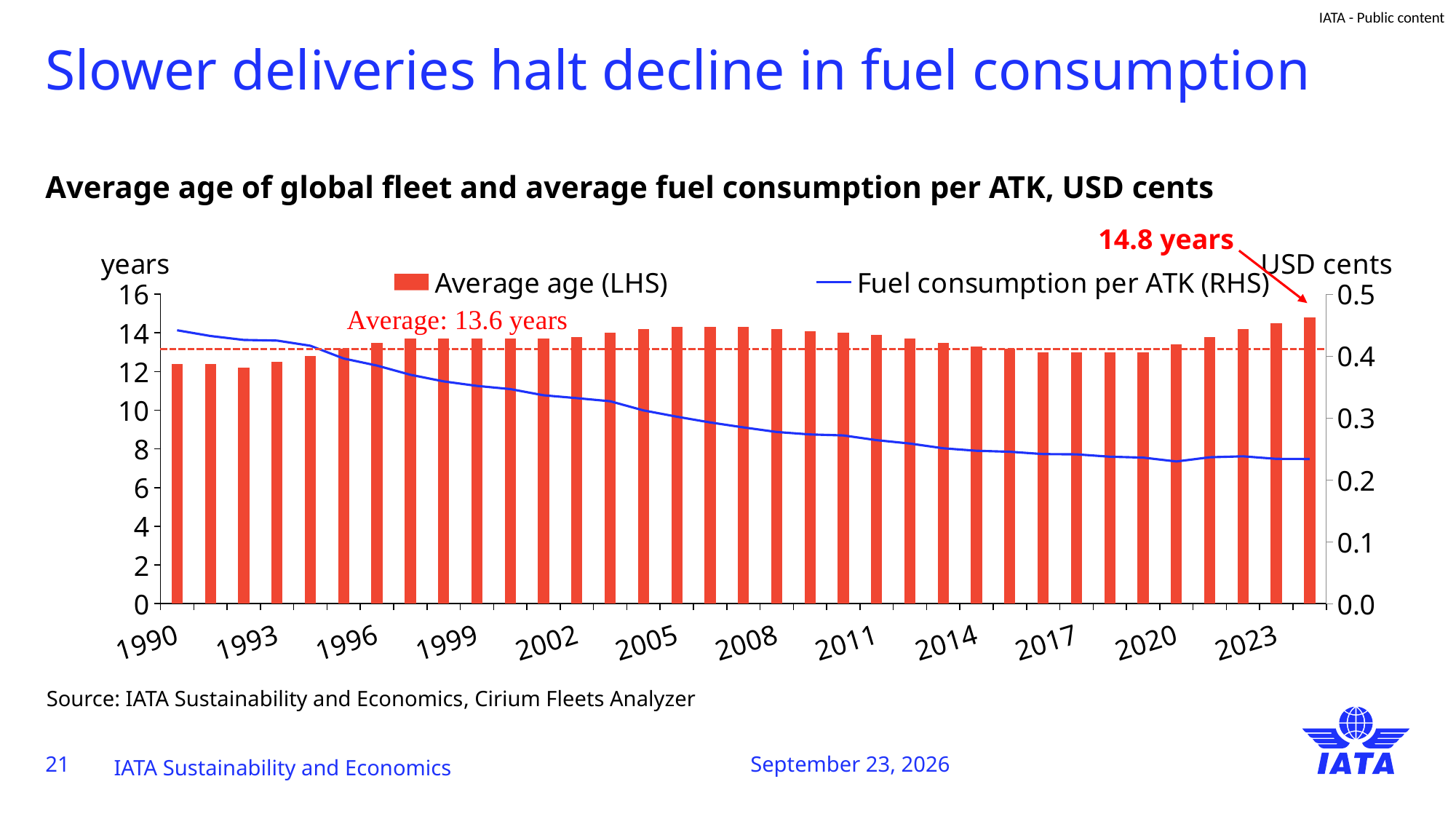
How many series does the legend list? 2 What value does the dashed horizontal line labelled 'Average' represent? 13.6 years Does the fuel consumption per ATK line rise or fall from 1990 to 2024? Fall Which is larger, fuel consumption per ATK in 1990 or in 2020? 1990 Which is larger, the average fleet age in 1990 or in 2024? 2024 What kind of chart is this? Combined bar and line chart What unit is shown on the right-hand axis? USD cents What is the average age of the global fleet shown for the final bar (2024)? 14.8 years Is the average fleet age in 1990 greater or less than 14 years? less Is the fuel consumption per ATK in 2023 greater or less than 0.3 USD cents? less Is the fuel consumption per ATK in 1990 greater or less than 0.4 USD cents? greater Which year has the highest average fleet age bar? 2024